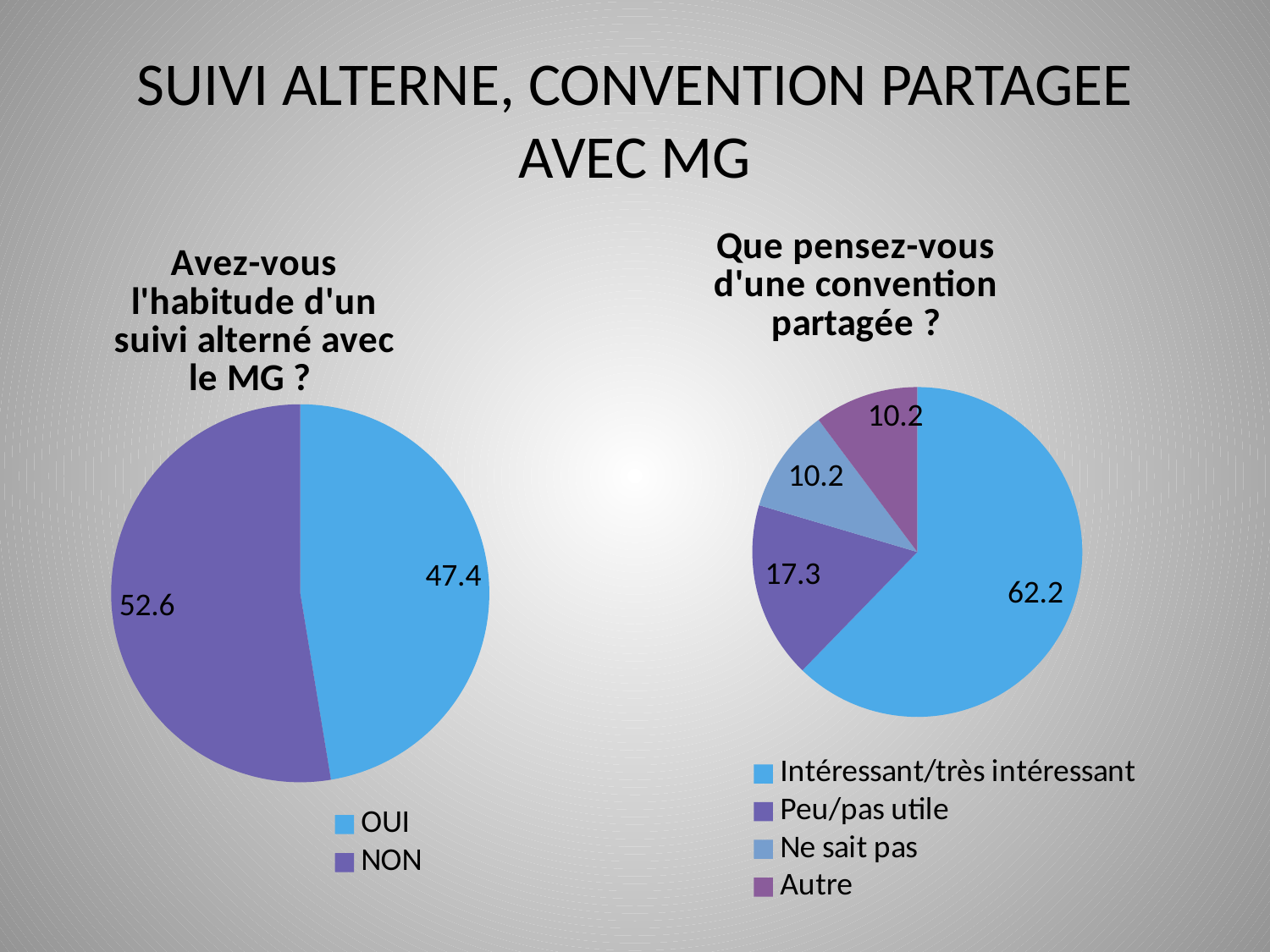
In the left chart ("Avez-vous l'habitude d'un suivi alterné avec le MG ?"), what is the difference between the NON and OUI values? 5.2 In the right chart ("Que pensez-vous d'une convention partagée ?"), what is the value for Intéressant/très intéressant? 62.2 In the right chart ("Que pensez-vous d'une convention partagée ?"), what is the value for Ne sait pas? 10.2 What kind of chart is the left chart ("Avez-vous l'habitude d'un suivi alterné avec le MG ?")? Pie chart In the left chart ("Avez-vous l'habitude d'un suivi alterné avec le MG ?"), what is the value for OUI? 47.4 In the left chart ("Avez-vous l'habitude d'un suivi alterné avec le MG ?"), which category has the larger share, OUI or NON? NON In the right chart ("Que pensez-vous d'une convention partagée ?"), what is the difference between the Intéressant/très intéressant and Peu/pas utile values? 44.9 In the right chart ("Que pensez-vous d'une convention partagée ?"), which category has the largest share? Intéressant/très intéressant In the right chart ("Que pensez-vous d'une convention partagée ?"), how many categories does the legend list? 4 In the right chart ("Que pensez-vous d'une convention partagée ?"), what is the value for Peu/pas utile? 17.3 In the left chart ("Avez-vous l'habitude d'un suivi alterné avec le MG ?"), what is the value for NON? 52.6